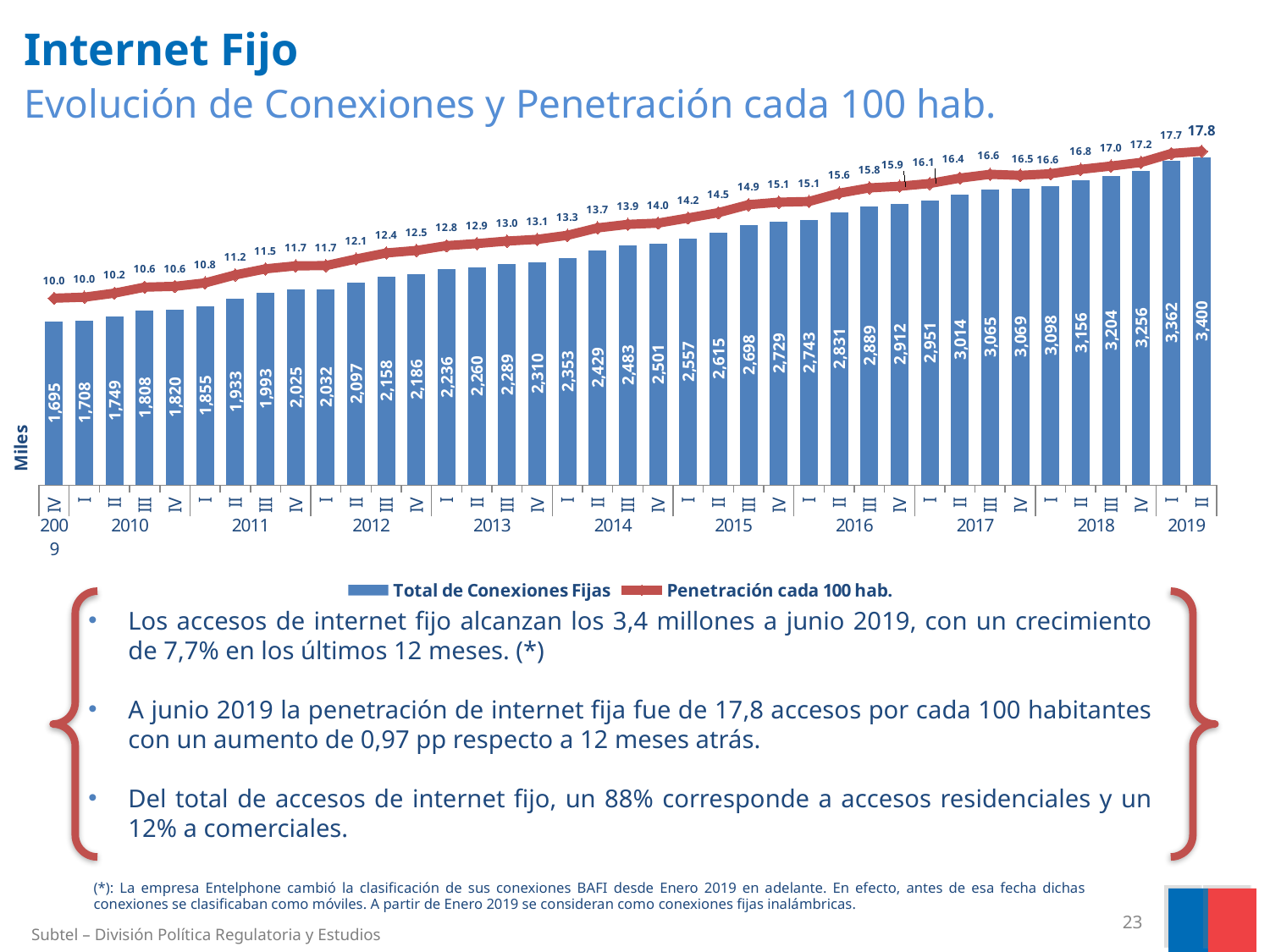
Which quarter has the highest Total de Conexiones Fijas? II 2019 How many quarters are plotted on the chart? 39 Which quarter has the lowest Total de Conexiones Fijas? IV 2009 What is the Penetración cada 100 hab. value for quarter II of 2017? 16.4 What kind of chart is used to show Total de Conexiones Fijas? Bar chart Which is larger, the Penetración cada 100 hab. value for quarter III of 2017 or for quarter IV of 2017? III 2017 What is the difference in Total de Conexiones Fijas between quarter II of 2019 and quarter II of 2018? 244 What is the Penetración cada 100 hab. value for quarter IV of 2009? 10.0 Does the Total de Conexiones Fijas generally rise or fall from 2009 to 2019? Rise How many series does the legend list? 2 What is the value of Total de Conexiones Fijas for quarter II of 2019? 3,400 What is the value of Total de Conexiones Fijas for quarter I of 2016? 2,743